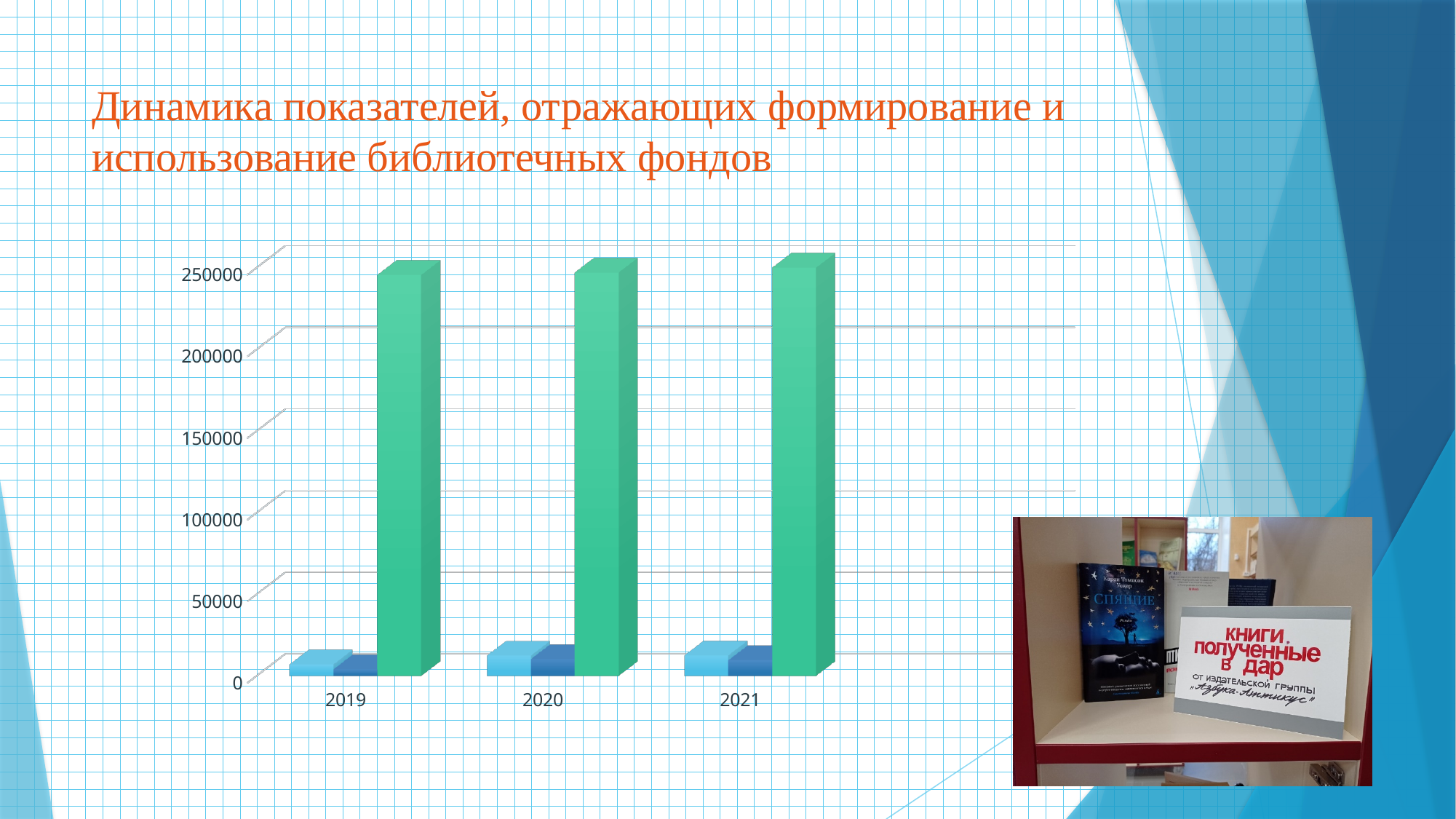
For 2019, which bar is larger: the dark blue bar or the green bar? the green bar How many years are shown on the x axis of the chart? 3 Is the value of the green bar for 2021 greater or less than 200000? greater For 2020, which bar is larger: the green bar or the light blue bar? the green bar Which years are shown on the x axis of the chart? 2019, 2020, 2021 What kind of chart is shown on the slide? bar chart What is the highest value labelled on the vertical axis of the chart? 250000 Is the value of the dark blue bar for 2021 greater or less than 50000? less Is the value of the green bar for 2019 greater or less than 200000? greater How many bars are plotted for each year in the chart? 3